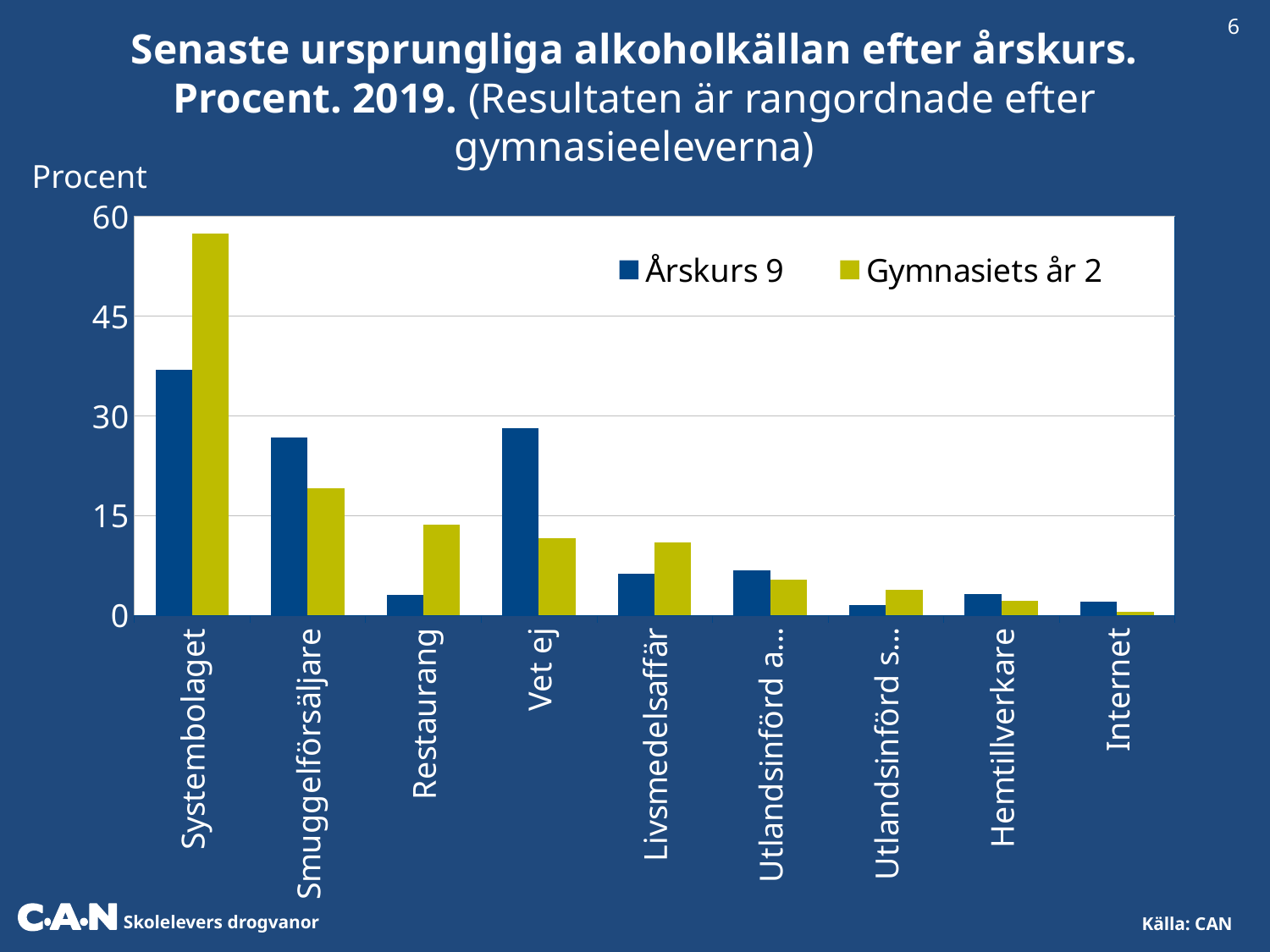
Is the value for Systembolaget in the Gymnasiets år 2 series greater or less than 45? greater For Vet ej, which series has the larger value, Årskurs 9 or Gymnasiets år 2? Årskurs 9 How many series does the legend list? 2 Is the value for Restaurang in the Gymnasiets år 2 series greater or less than 15? less For Restaurang, which series has the larger value, Årskurs 9 or Gymnasiets år 2? Gymnasiets år 2 Is the value for Systembolaget in the Årskurs 9 series greater or less than 45? less How many categories are shown on the x axis? 9 Which category has the highest value for Årskurs 9? Systembolaget Which category has the highest value for Gymnasiets år 2? Systembolaget Which category has the lowest value for Gymnasiets år 2? Internet What are the two series named in the legend? Årskurs 9 and Gymnasiets år 2 What kind of chart is shown on the slide? bar chart